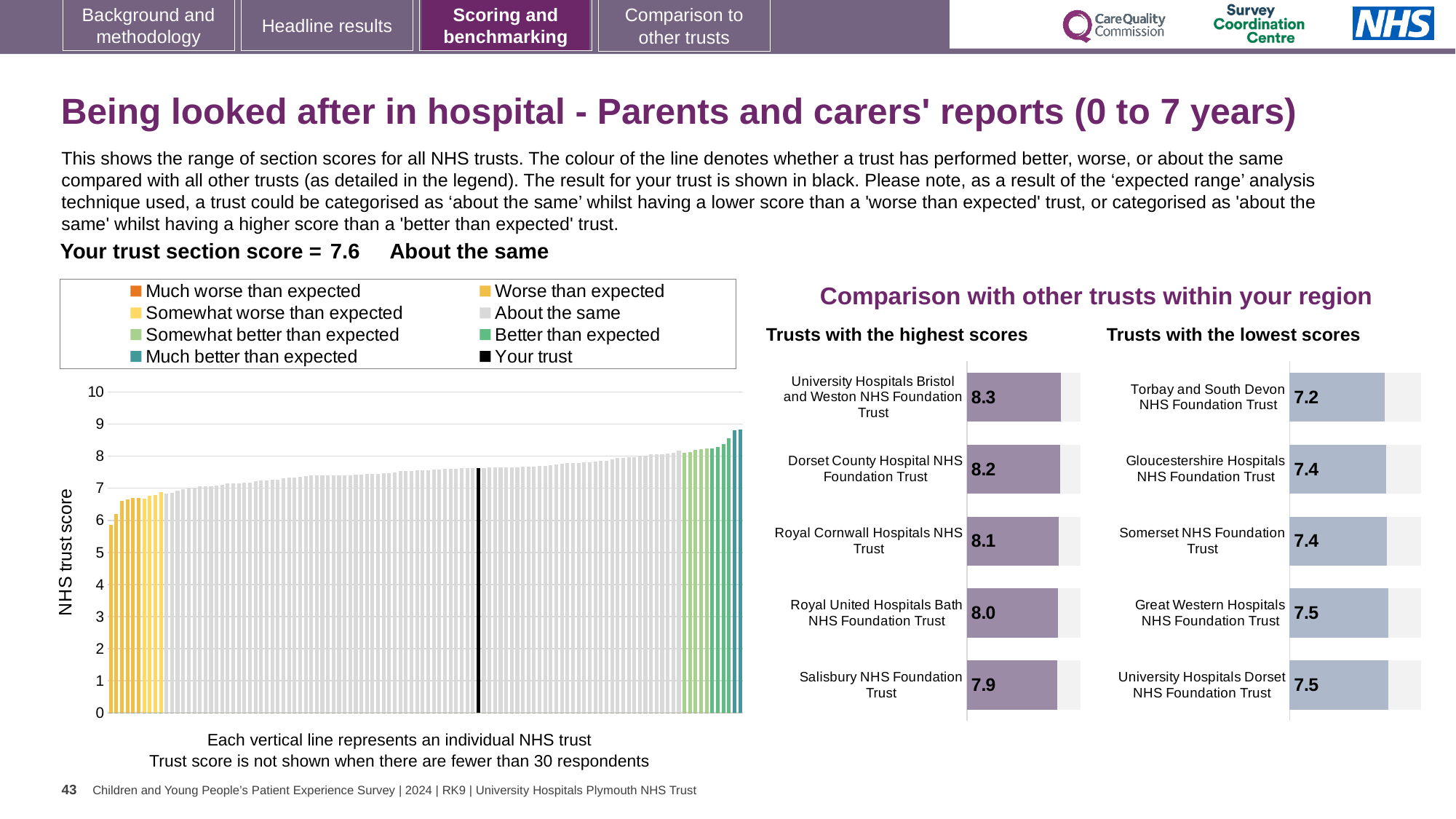
In the 'Trusts with the highest scores' chart, which trust has the lowest score? Salisbury NHS Foundation Trust In the 'Trusts with the highest scores' chart, what is the score for Royal United Hospitals Bath NHS Foundation Trust? 8.0 In the 'Trusts with the lowest scores' chart, what is the score for Torbay and South Devon NHS Foundation Trust? 7.2 In the large chart on the left, is the value of the tallest bar greater or less than 8? greater How many trusts are shown in the 'Trusts with the lowest scores' chart? 5 In the large chart on the left, do the trust scores rise or fall from left to right? Rise In the 'Trusts with the highest scores' chart, what is the difference between the scores of University Hospitals Bristol and Weston NHS Foundation Trust and Salisbury NHS Foundation Trust? 0.4 How many entries does the legend of the large chart on the left list? 8 In the 'Trusts with the highest scores' chart, what is the score for University Hospitals Bristol and Weston NHS Foundation Trust? 8.3 In the 'Trusts with the lowest scores' chart, which trust has the lowest score? Torbay and South Devon NHS Foundation Trust In the 'Trusts with the lowest scores' chart, which has the larger score: Gloucestershire Hospitals NHS Foundation Trust or Great Western Hospitals NHS Foundation Trust? Great Western Hospitals NHS Foundation Trust What kind of chart is the large chart on the left showing NHS trust scores? Bar chart